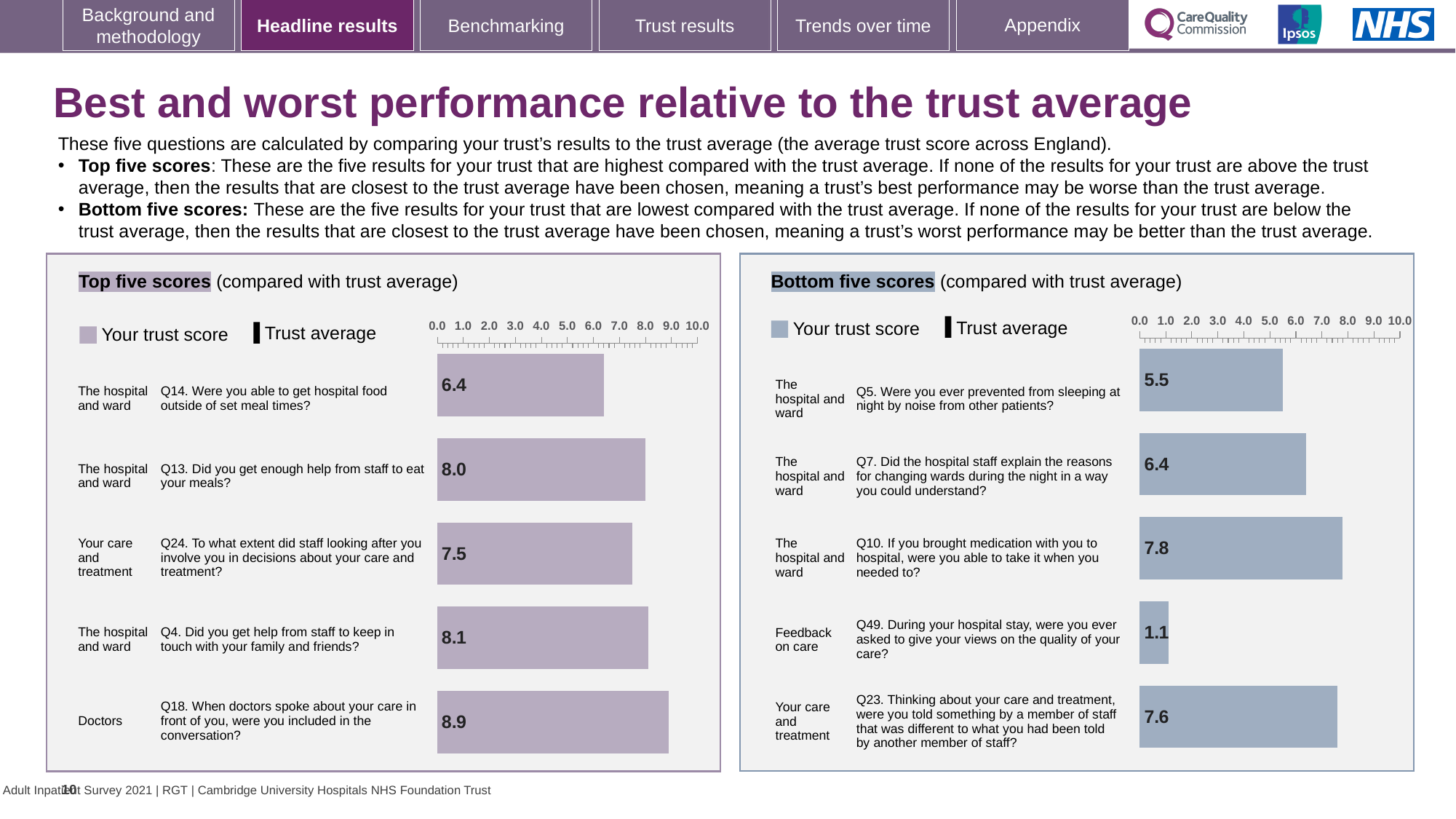
How many questions are plotted in the 'Top five scores' chart? 5 What type of chart is the 'Bottom five scores' chart? Bar chart In the 'Top five scores' chart, what is the difference between the trust scores for Q18 and Q14? 2.5 In the 'Top five scores' chart, what is the trust score for Q14 (able to get hospital food outside of set meal times)? 6.4 What two items does the legend of the 'Top five scores' chart list? Your trust score and Trust average In the 'Bottom five scores' chart, what is the trust score for Q10 (able to take medication brought with you when needed)? 7.8 In the 'Top five scores' chart, what is the trust score for Q18 (included in the conversation when doctors spoke about your care)? 8.9 In the 'Top five scores' chart, which question has the highest trust score? Q18 In the 'Bottom five scores' chart, which has the larger trust score, Q5 or Q23? Q23 In the 'Bottom five scores' chart, is the trust score for Q7 greater or less than 5.0? greater In the 'Bottom five scores' chart, which question has the lowest trust score? Q49 In the 'Bottom five scores' chart, what is the trust score for Q49 (asked to give your views on the quality of your care)? 1.1